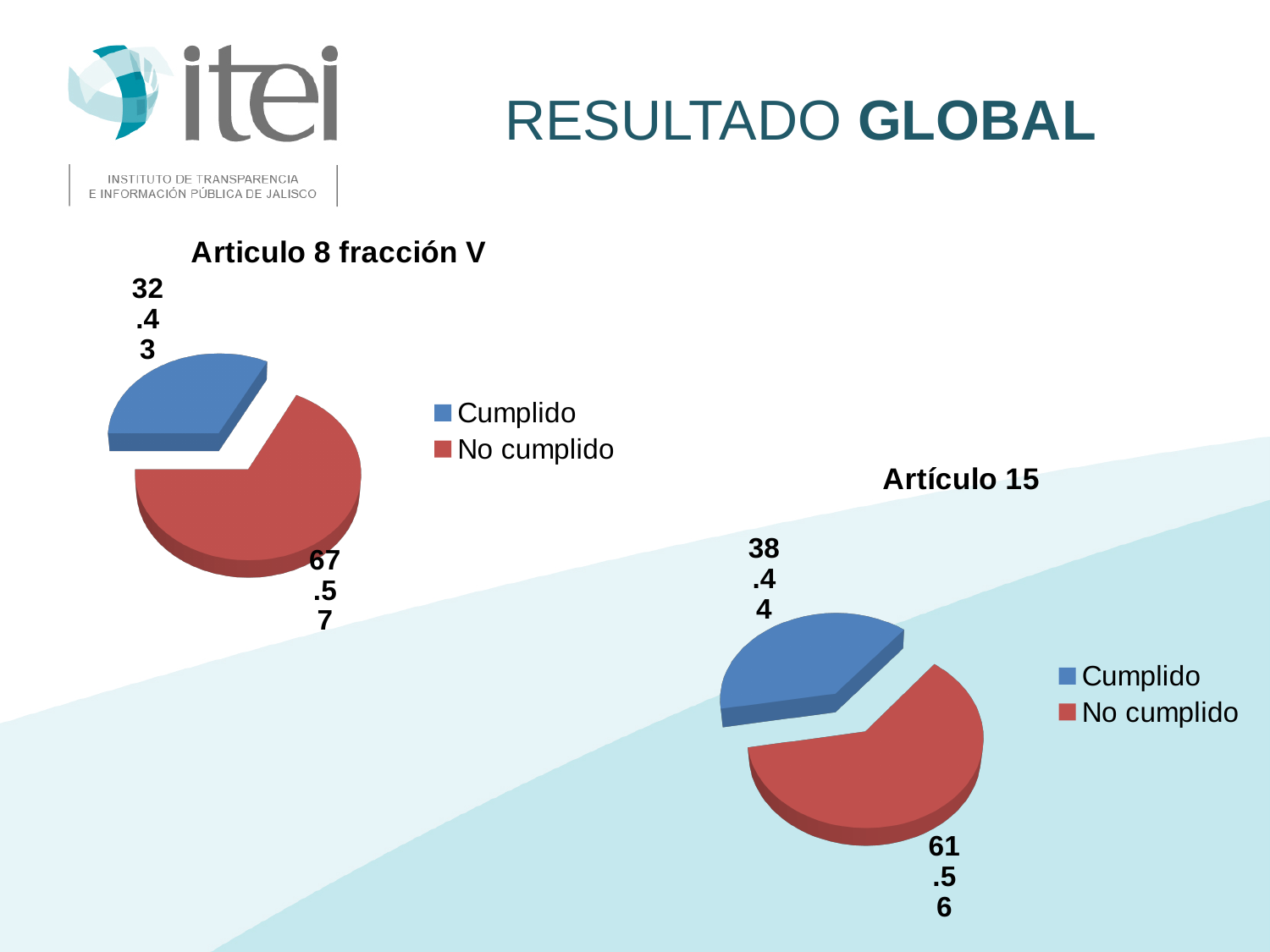
In the 'Articulo 8 fracción V' chart, what is the value for Cumplido? 32.43 In the 'Artículo 15' chart, what is the difference between No cumplido and Cumplido? 23.12 What type of chart is the 'Artículo 15' chart? Pie chart In the 'Articulo 8 fracción V' chart, which slice is the largest? No cumplido In the 'Artículo 15' chart, which slice is the smallest? Cumplido Which chart has the larger Cumplido value, 'Articulo 8 fracción V' or 'Artículo 15'? Artículo 15 In the 'Artículo 15' chart, what is the value for Cumplido? 38.44 In the 'Articulo 8 fracción V' chart, what is the difference between No cumplido and Cumplido? 35.14 How many entries does the legend of the 'Articulo 8 fracción V' chart list? 2 In the 'Artículo 15' chart, what is the value for No cumplido? 61.56 In the 'Articulo 8 fracción V' chart, what is the value for No cumplido? 67.57 In the 'Artículo 15' chart, what colour is the No cumplido slice? Red